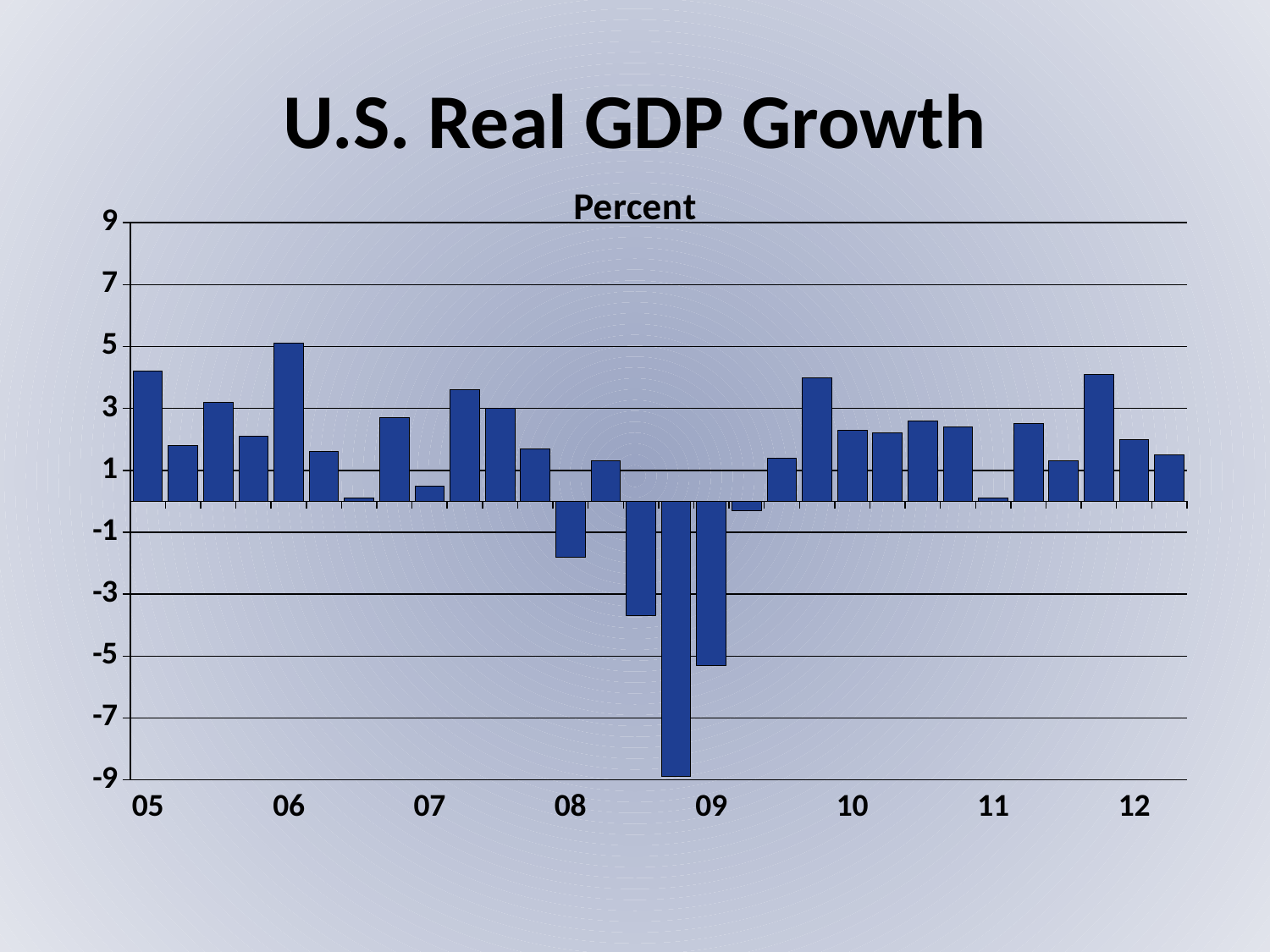
How many year labels are shown along the x axis? 8 Between which two x-axis year labels does the lowest bar fall? 08 and 09 Is the value of the bar directly above the 07 label greater or less than 1? less Do the bars immediately following the lowest bar rise or fall? rise Is the value of the lowest bar greater or less than -7? less Which x-axis year label is the tallest bar directly above? 06 What kind of chart is shown on the slide? bar chart What is the title of the chart? U.S. Real GDP Growth Which is larger: the bar directly above the 05 label or the bar directly above the 10 label? 05 What unit label is shown above the y axis of the chart? Percent Is the value of the bar directly above the 05 label greater or less than 3? greater